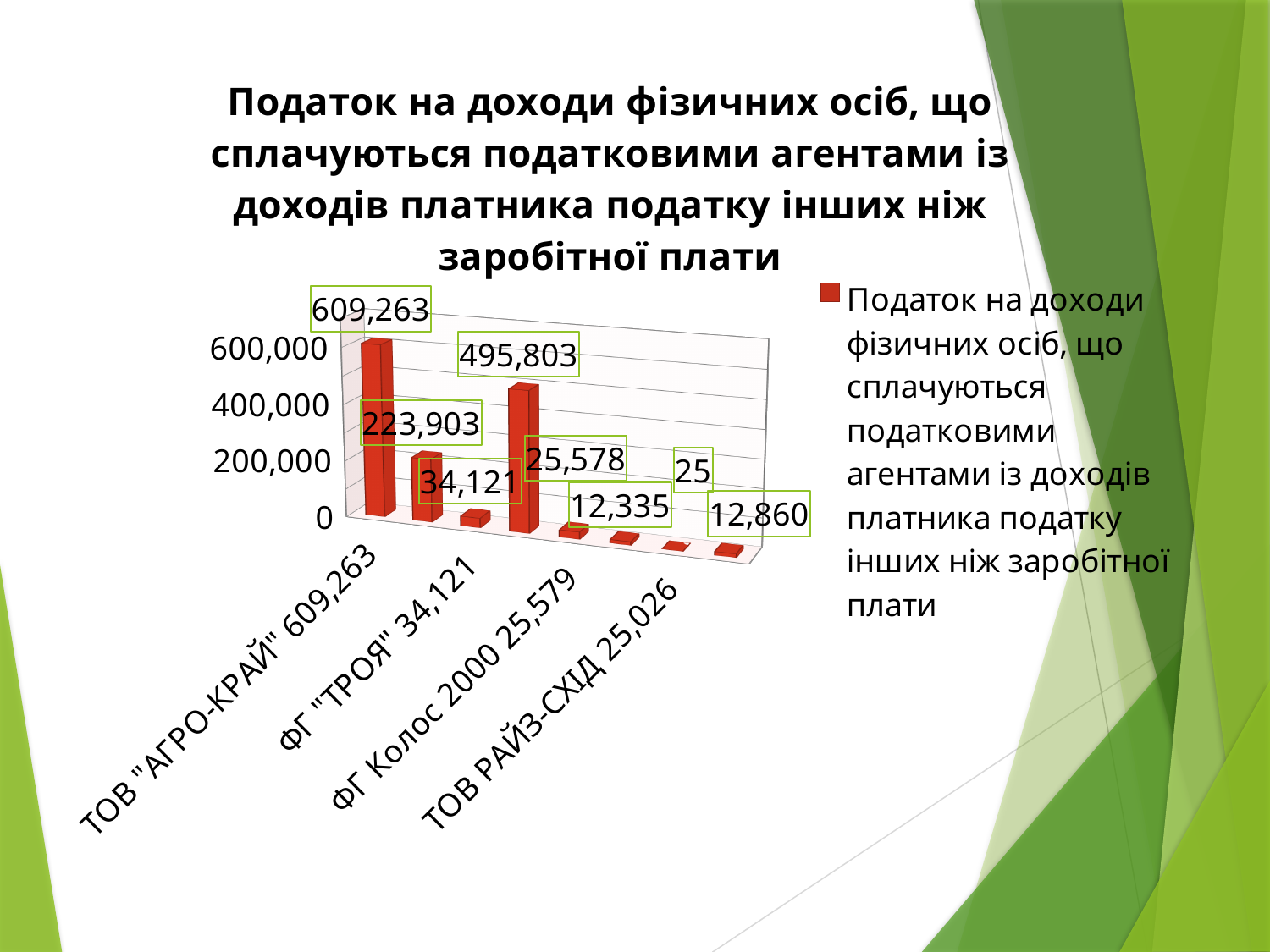
Which category has the highest value in the chart? ТОВ "АГРО-КРАЙ" Is the value for ТОВ "АГРО-КРАЙ" greater or less than 600,000? greater How many series does the legend list? 1 What kind of chart is shown on the slide? bar chart How much larger is the value for ТОВ "АГРО-КРАЙ" than the value for ФГ "ТРОЯ"? 575,142 Is the value for ФГ "ТРОЯ" greater or less than 200,000? less What is the difference between the tallest bar (609,263) and the second-tallest bar (495,803)? 113,460 How many bars are plotted in the chart? 8 What is the value shown on the second-tallest bar? 495,803 What is the value for ФГ "ТРОЯ"? 34,121 What is the value for ТОВ "АГРО-КРАЙ"? 609,263 Which is larger, the value for ТОВ "АГРО-КРАЙ" or the value for ФГ "ТРОЯ"? ТОВ "АГРО-КРАЙ"